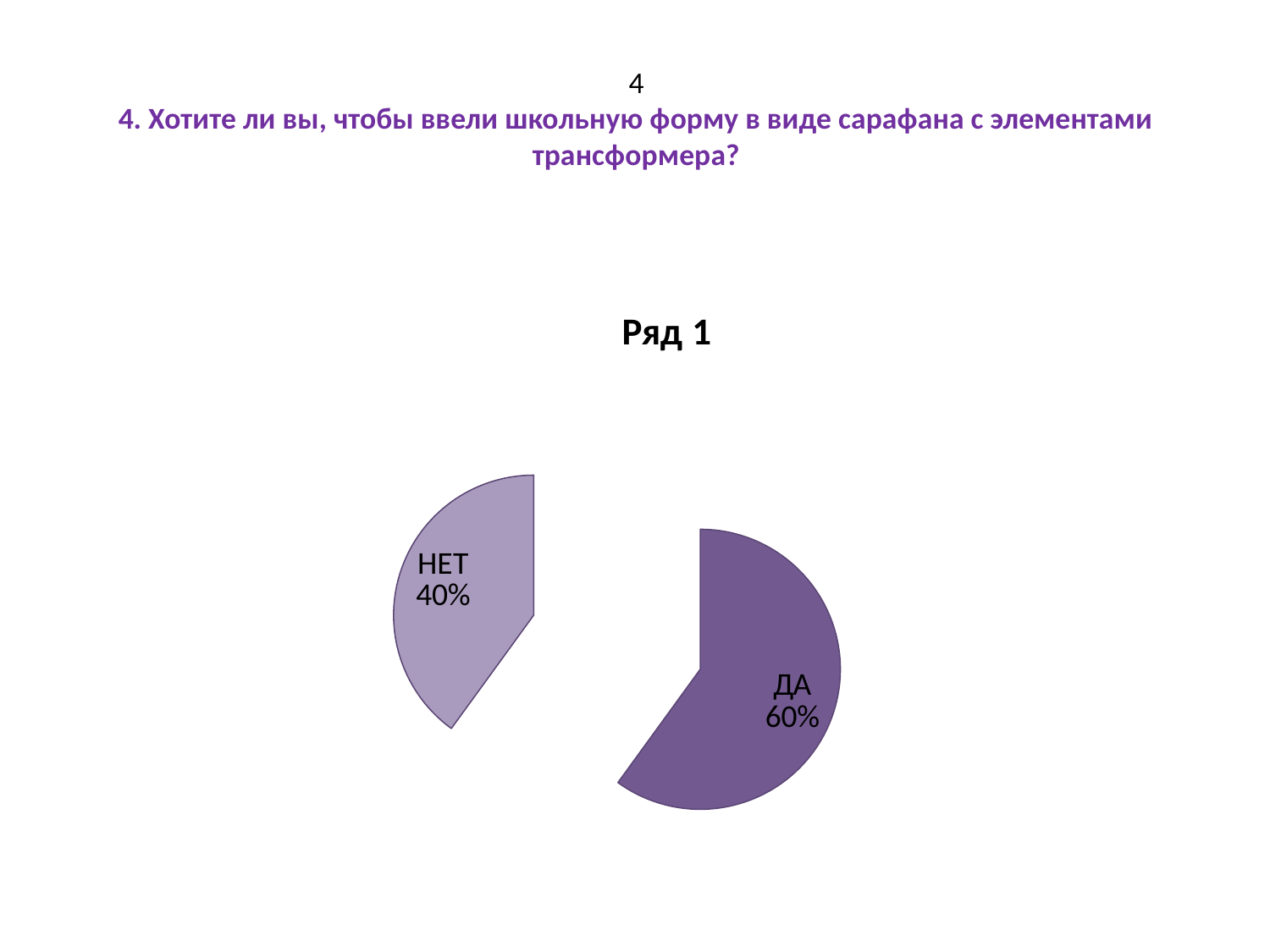
Which slice is the smallest in the pie chart? НЕТ Is the share for НЕТ greater or less than 50%? less What share of the pie does the ДА slice represent? 60% How many slices does the pie chart have? 2 Is the share for ДА greater or less than 50%? greater What share of the pie does the НЕТ slice represent? 40% What kind of chart is shown on the slide? Pie chart Which is larger, the ДА slice or the НЕТ slice? ДА Which slice is the largest in the pie chart? ДА Which slice is drawn in the darker purple colour? ДА What is the title of the chart? Ряд 1 What is the difference in percentage points between the ДА and НЕТ slices? 20%